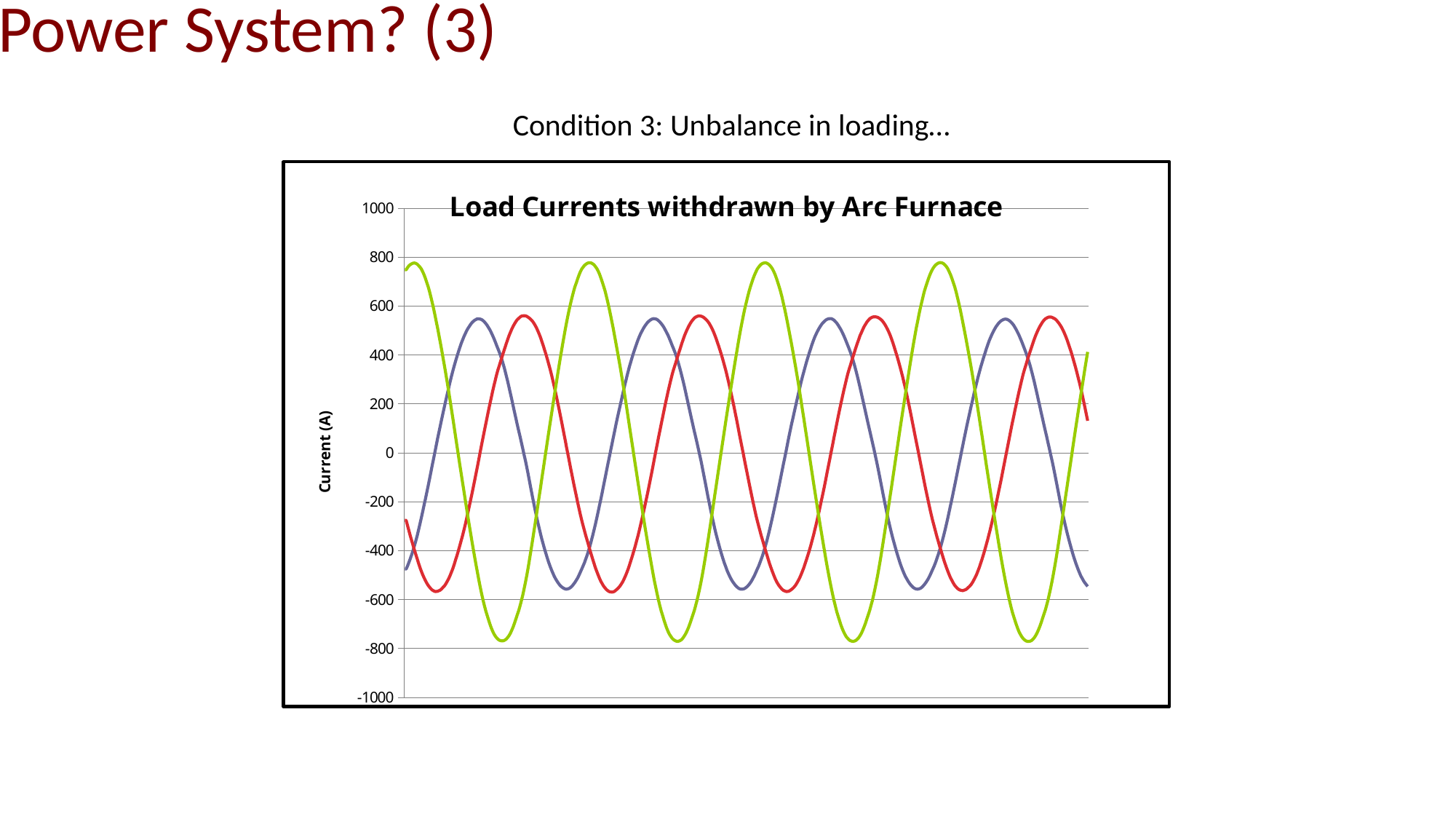
Which coloured line reaches the highest peak value on the chart? Green Is the peak value of the blue line greater or less than 600? less What is the title of the chart? Load Currents withdrawn by Arc Furnace Which coloured line reaches the lowest trough value on the chart? Green What is the label of the vertical axis of the chart? Current (A) What is the highest value shown on the vertical axis of the chart? 1000 What kind of chart is shown on the slide? Line chart How many lines (current waveforms) are plotted on the chart? 3 Is the peak value of the green line greater or less than 600? greater Which has a larger peak value, the green line or the blue line? Green line Is the lowest value of the green line greater or less than -600? less